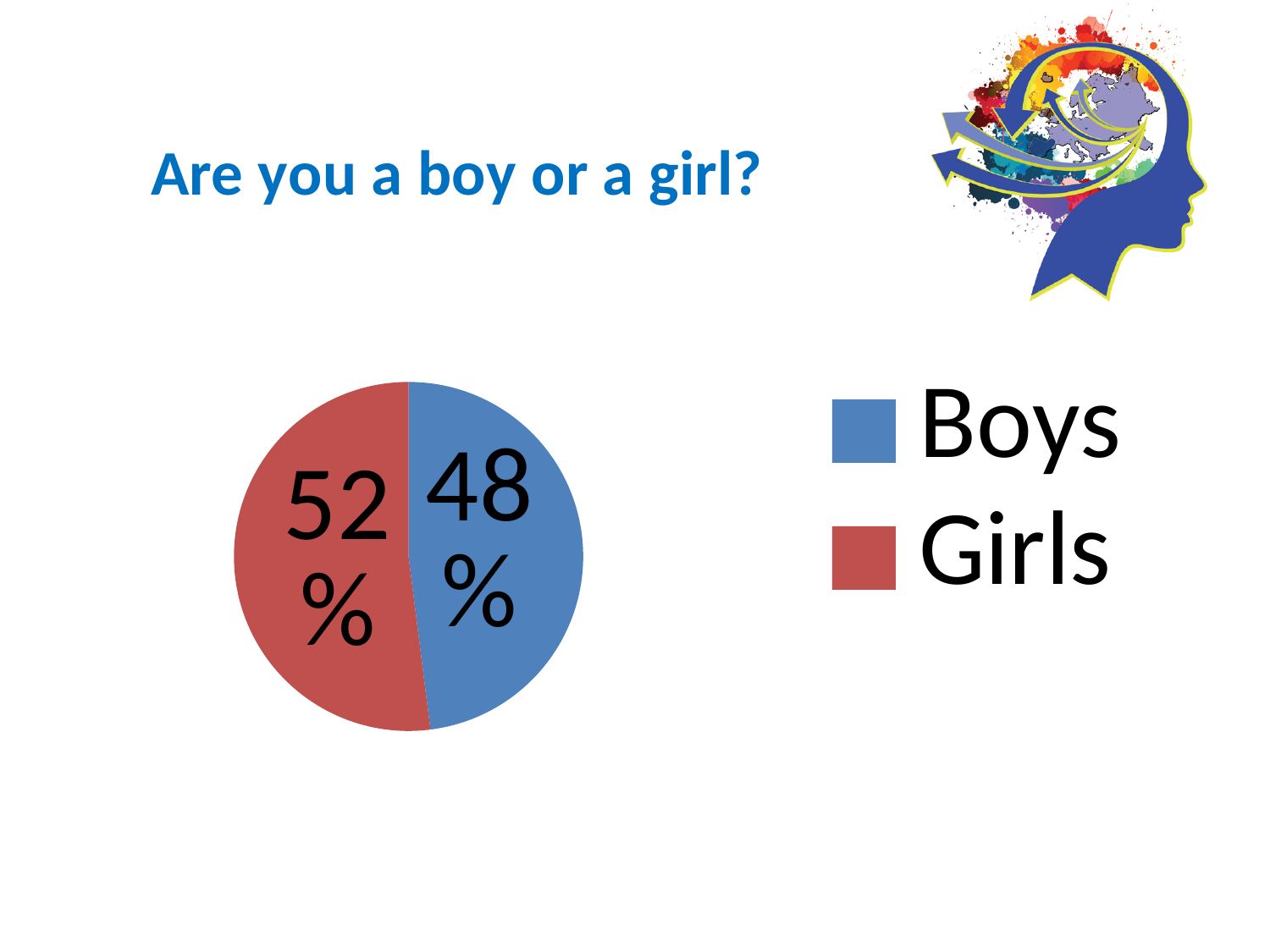
How many entries does the legend list? 2 Which is larger, the Boys slice or the Girls slice? Girls What percentage of the pie chart is Boys? 48% What is the title of the slide above the pie chart? Are you a boy or a girl? What share of the pie does the Boys slice represent? 48% How many slices does the pie chart have? 2 Which slice of the pie chart is the smallest? Boys Which slice of the pie chart is the largest? Girls What percentage of the pie chart is Girls? 52% What is the difference between the Girls and Boys percentages? 4% What kind of chart is shown on the slide? pie chart What colour is the Girls slice in the pie chart? red